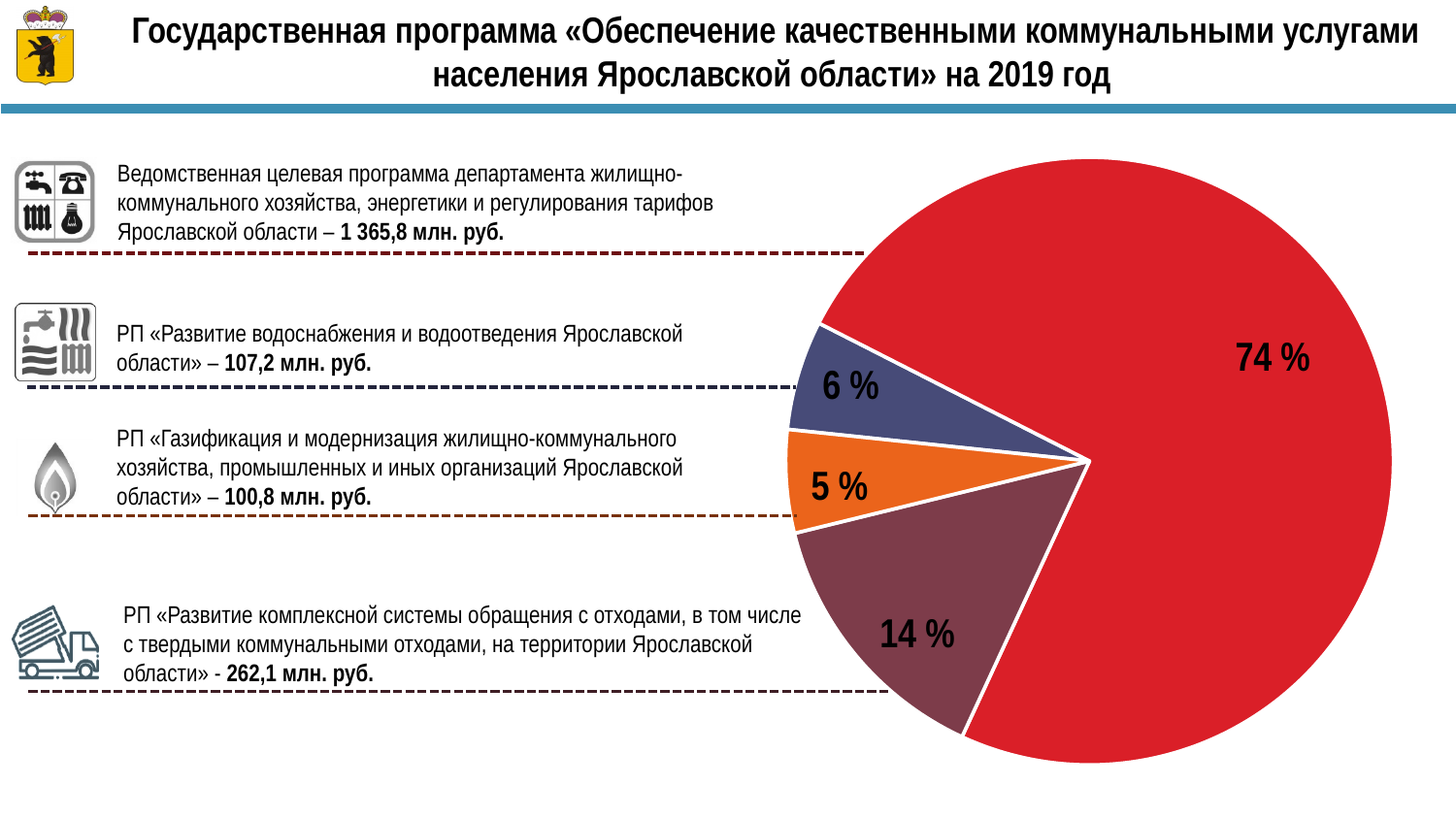
Is the largest slice of the pie chart greater or less than 50 %? greater What kind of chart is shown on the slide? Pie chart What is the percentage shown on the smallest slice of the pie chart? 5 % How many slices does the pie chart have? 4 Which slice is larger: the blue slice or the orange slice? The blue slice (6 %) What percentage is shown on the dark purple slice of the pie chart? 14 % What is the difference in percentage points between the largest slice (74 %) and the smallest slice (5 %)? 69 What is the difference in percentage points between the 14 % slice and the 6 % slice? 8 What is the combined share of the three smaller slices (14 %, 6 % and 5 %)? 25 % What colour is the 74 % slice of the pie chart? Red What percentage is shown on the orange slice of the pie chart? 5 % What is the percentage shown on the largest slice of the pie chart? 74 %